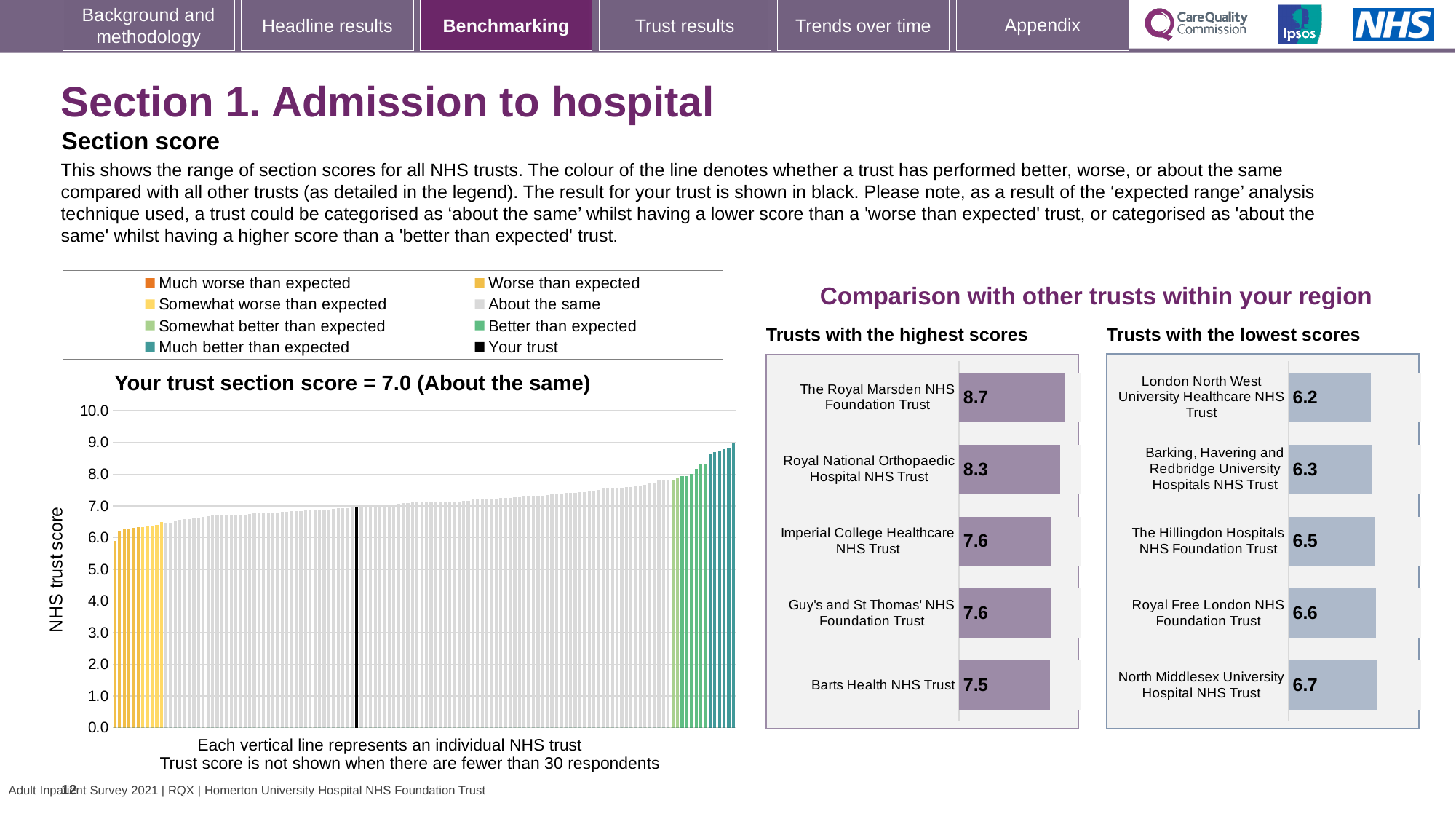
In the 'Trusts with the lowest scores' chart, what is the score for The Hillingdon Hospitals NHS Foundation Trust? 6.5 In the 'Your trust section score' chart, what is the section score for your trust? 7.0 In the 'Trusts with the lowest scores' chart, what is the difference between the scores of North Middlesex University Hospital NHS Trust and London North West University Healthcare NHS Trust? 0.5 In the 'Trusts with the lowest scores' chart, which is larger: the score for Royal Free London NHS Foundation Trust or Barking, Havering and Redbridge University Hospitals NHS Trust? Royal Free London NHS Foundation Trust In the 'Trusts with the lowest scores' chart, which trust has the lowest score? London North West University Healthcare NHS Trust In the 'Trusts with the highest scores' chart, how many trusts are shown? 5 What kind of chart is the 'Your trust section score' chart? Bar chart How many entries does the legend above the 'Your trust section score' chart list? 8 In the 'Trusts with the highest scores' chart, what is the score for The Royal Marsden NHS Foundation Trust? 8.7 In the 'Trusts with the highest scores' chart, which trust has the highest score? The Royal Marsden NHS Foundation Trust In the 'Trusts with the highest scores' chart, what is the difference between the scores of The Royal Marsden NHS Foundation Trust and Barts Health NHS Trust? 1.2 In the 'Trusts with the highest scores' chart, what is the score for Barts Health NHS Trust? 7.5